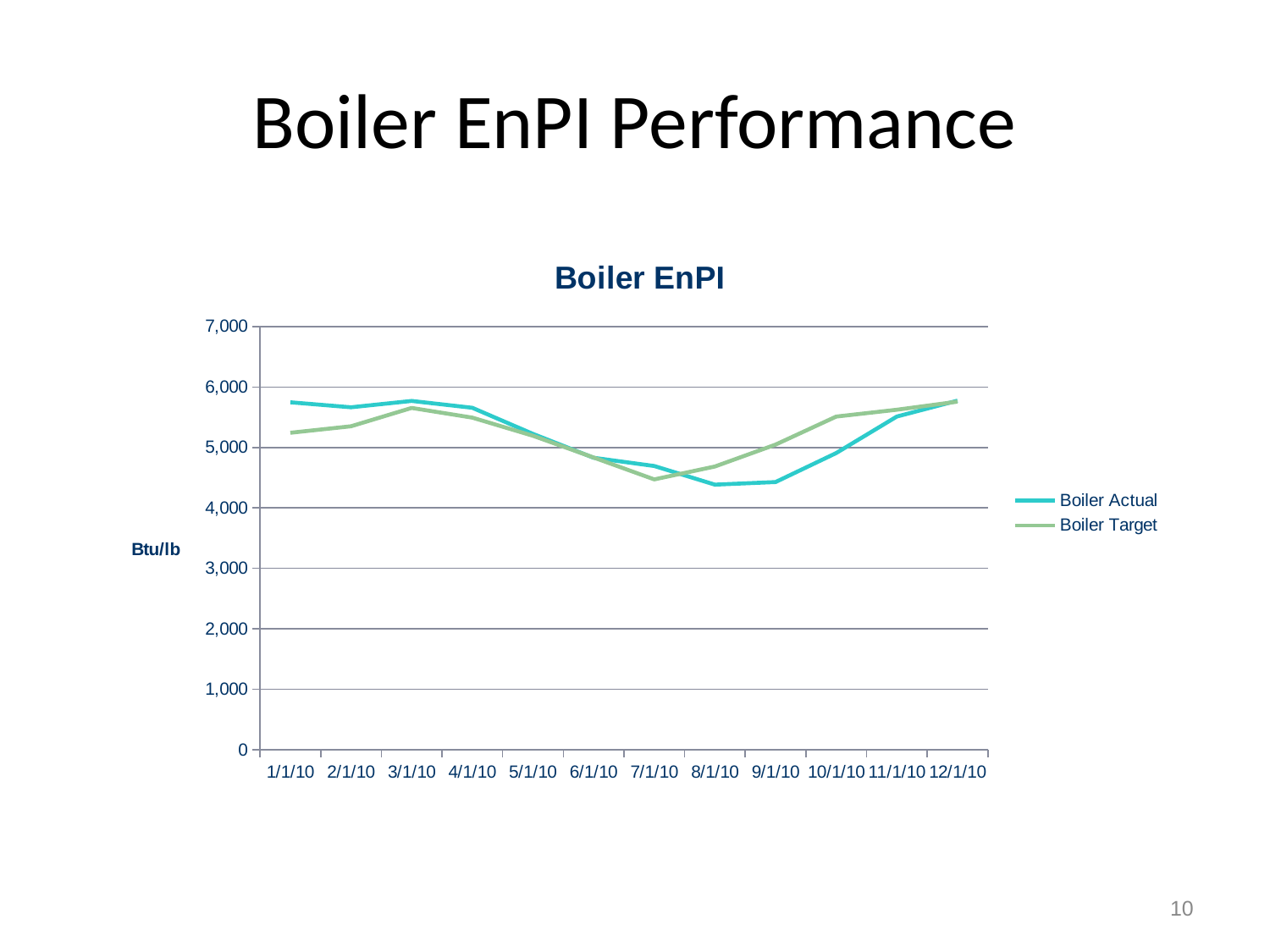
How many dates are plotted along the x axis? 12 Is the Boiler Actual value for 8/1/10 greater or less than 5,000? less Is the Boiler Actual value for 1/1/10 greater or less than 5,000? greater What is the title of the chart? Boiler EnPI Is the Boiler Target value for 7/1/10 greater or less than 5,000? less At 1/1/10, which series has the higher value, Boiler Actual or Boiler Target? Boiler Actual On which date is the Boiler Target value highest? 12/1/10 How many series does the legend list? 2 What is the label on the vertical axis? Btu/lb What kind of chart is shown on the slide? line chart On which date is the Boiler Target value lowest? 7/1/10